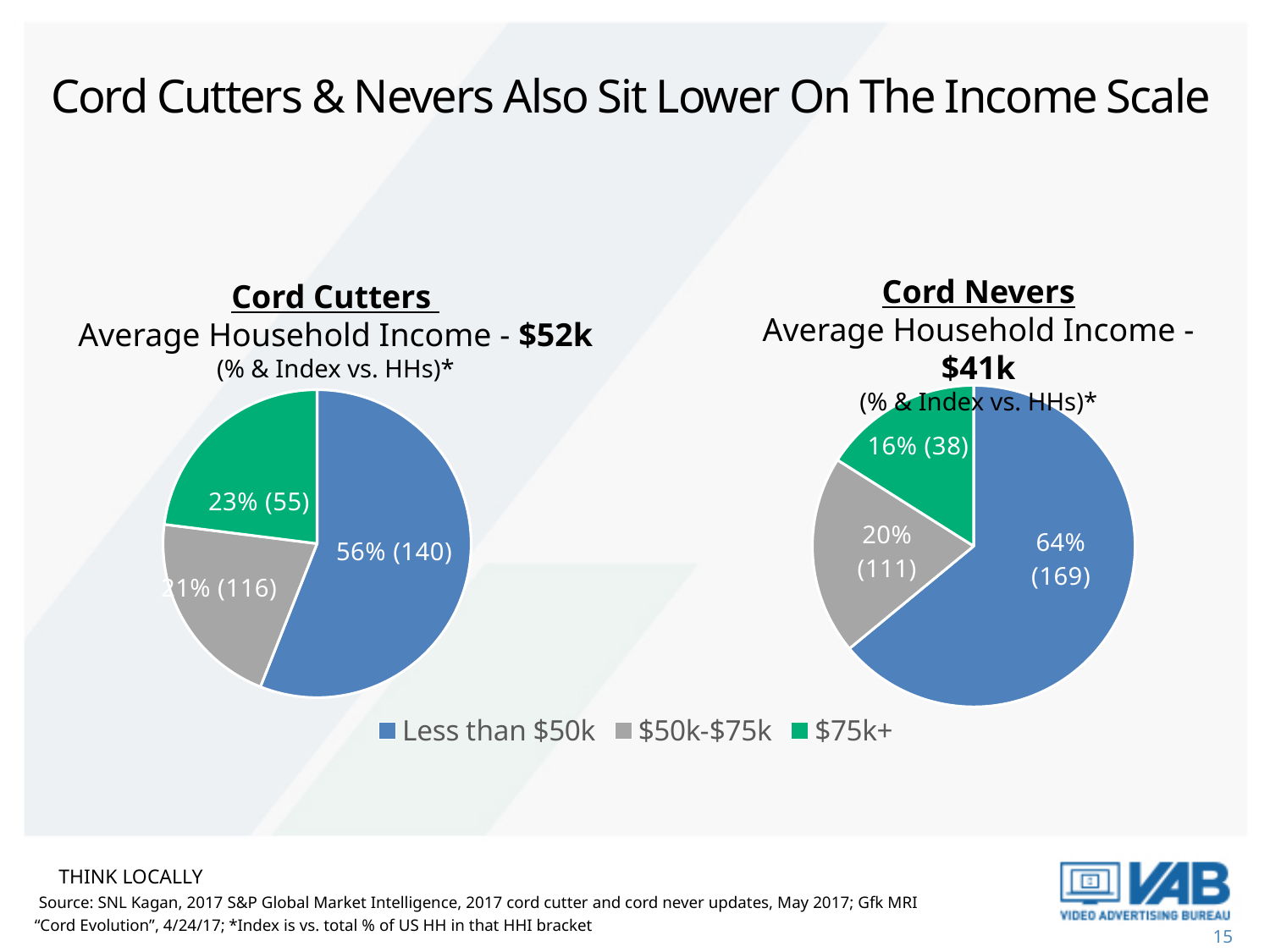
On the Cord Nevers chart, which income bracket has the smallest slice? $75k+ On the Cord Nevers chart, what is the index value shown for the $50k-$75k slice? 111 Which chart shows a larger share for the $75k+ bracket, Cord Cutters or Cord Nevers? Cord Cutters What average household income is stated in the Cord Nevers chart title? $41k How many entries does the shared legend list? 3 On the Cord Nevers chart, which income bracket has the largest slice? Less than $50k On the Cord Cutters chart, what share of households have income less than $50k? 56% What kind of chart is used for the Cord Cutters data? Pie chart On the Cord Nevers chart, what share of households have income less than $50k? 64% On the Cord Nevers chart, what share of households have income of $75k+? 16% On the Cord Cutters chart, what is the index value shown for the $75k+ slice? 55 What is the difference in the Less than $50k share between the Cord Nevers chart and the Cord Cutters chart? 8 percentage points